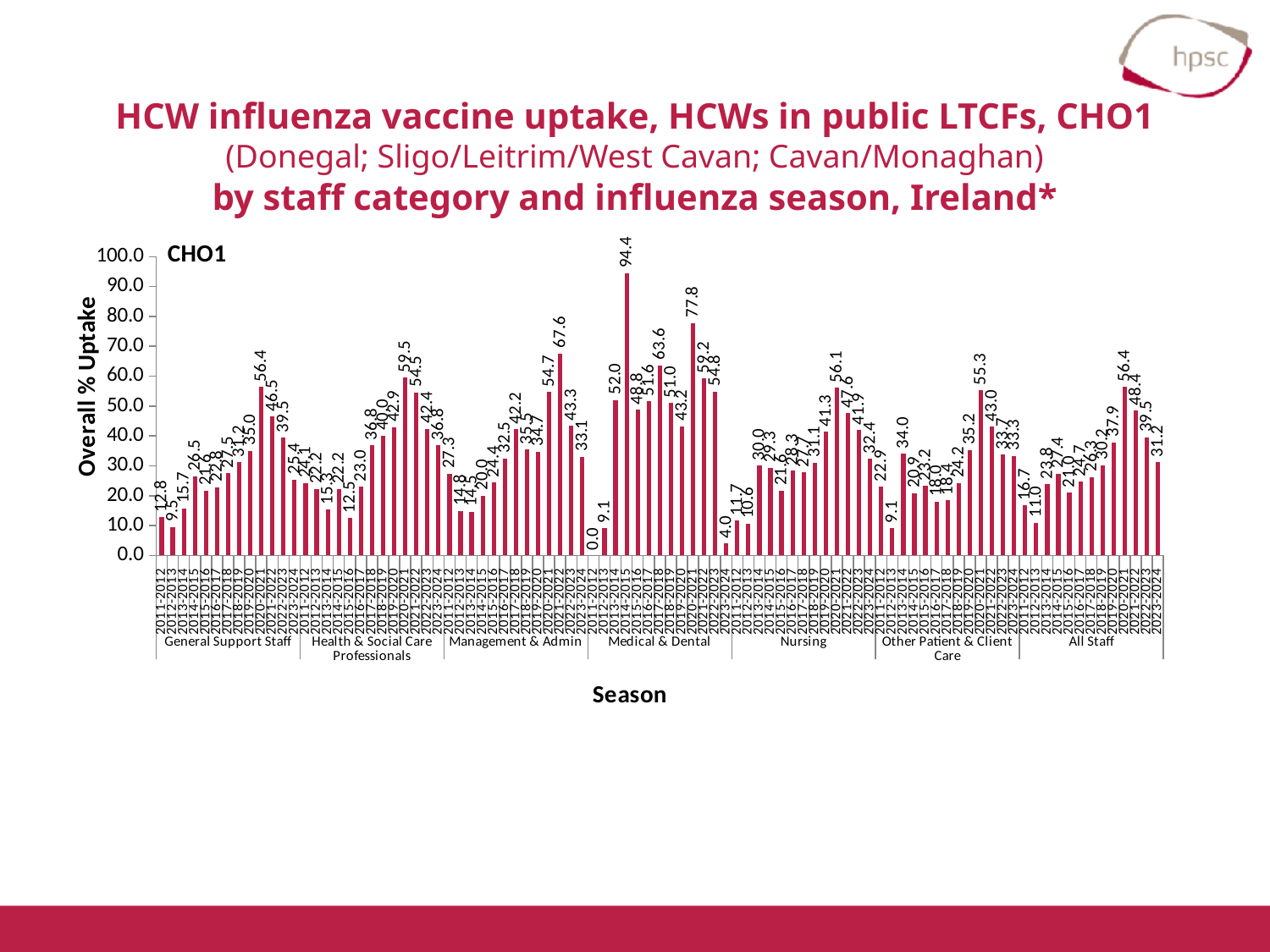
What is the overall % uptake for Management & Admin in the 2020-2021 season? 54.7 Which season has the lowest overall % uptake within the Medical & Dental category? 2011-2012 What type of chart is shown on the slide? Bar chart What is the overall % uptake for Medical & Dental in the 2011-2012 season? 0.0 What is the overall % uptake for Medical & Dental in the 2014-2015 season? 94.4 What is the title of the y axis? Overall % Uptake What is the overall % uptake for All Staff in the 2023-2024 season? 31.2 How many staff categories are shown along the x axis? 7 What is the difference between the Medical & Dental values for 2014-2015 and 2020-2021? 16.6 Is the value for All Staff in 2020-2021 greater or less than 50? greater What is the overall % uptake for Nursing in the 2011-2012 season? 11.7 Which staff category and season has the highest overall % uptake in the chart? Medical & Dental, 2014-2015